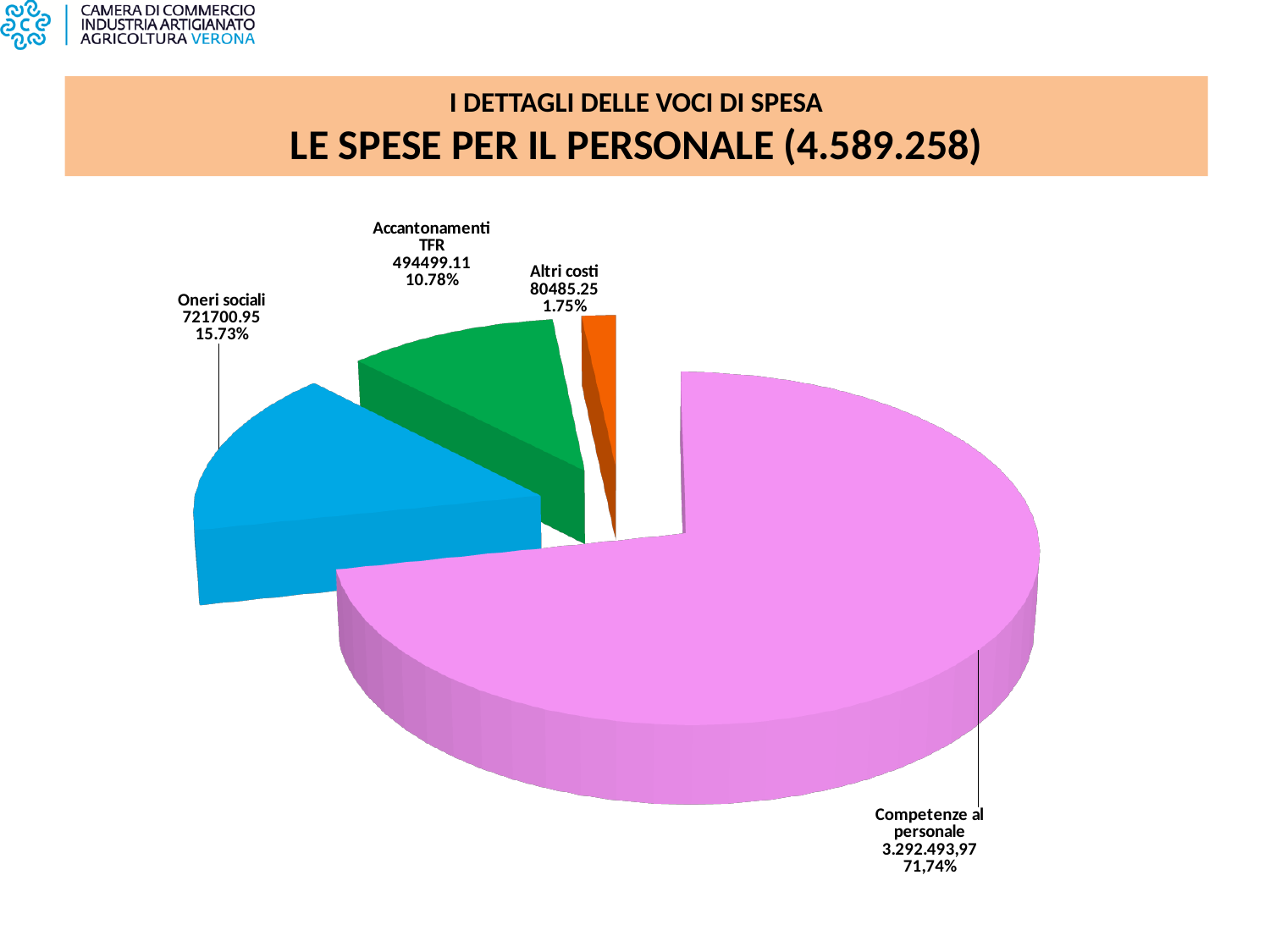
Which category has the smallest slice of the pie? Altri costi What is the value shown for Altri costi? 80485.25 What colour is the Competenze al personale slice? pink What percentage share is shown for Accantonamenti TFR? 10.78% What percentage share is shown for Competenze al personale? 71,74% What is the value shown for Oneri sociali? 721700.95 Which category has the largest slice of the pie? Competenze al personale What is the value shown for Accantonamenti TFR? 494499.11 What kind of chart is shown on the slide? pie chart Which is larger, Oneri sociali or Accantonamenti TFR? Oneri sociali What percentage share is shown for Oneri sociali? 15.73% How many slices does the pie chart have? 4